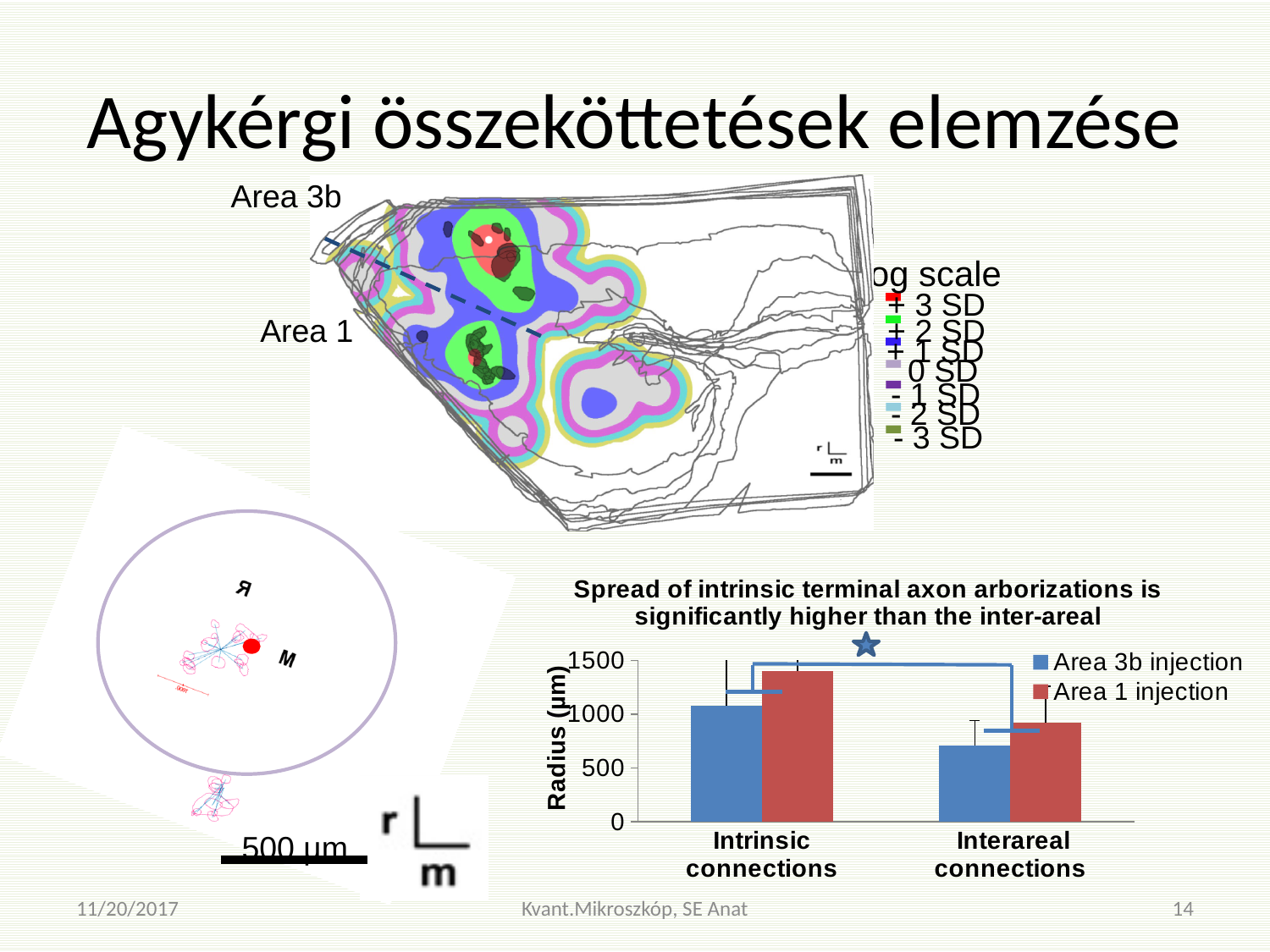
Which series in the bar chart is shown in blue? Area 3b injection For Intrinsic connections, which is larger: Area 3b injection or Area 1 injection? Area 1 injection What kind of chart is shown at the bottom right of the slide? bar chart How many series does the legend of the bar chart list? 2 Is the value for Area 1 injection in Intrinsic connections greater or less than 1000? greater Is the value for Area 1 injection in Interareal connections greater or less than 500? greater What is the label of the y axis of the bar chart? Radius (µm) How many categories are shown on the x axis of the bar chart? 2 Which bar in the chart is the highest? Area 1 injection, Intrinsic connections Which bar in the chart is the lowest? Area 3b injection, Interareal connections Is the value for Area 3b injection in Interareal connections greater or less than 1000? less